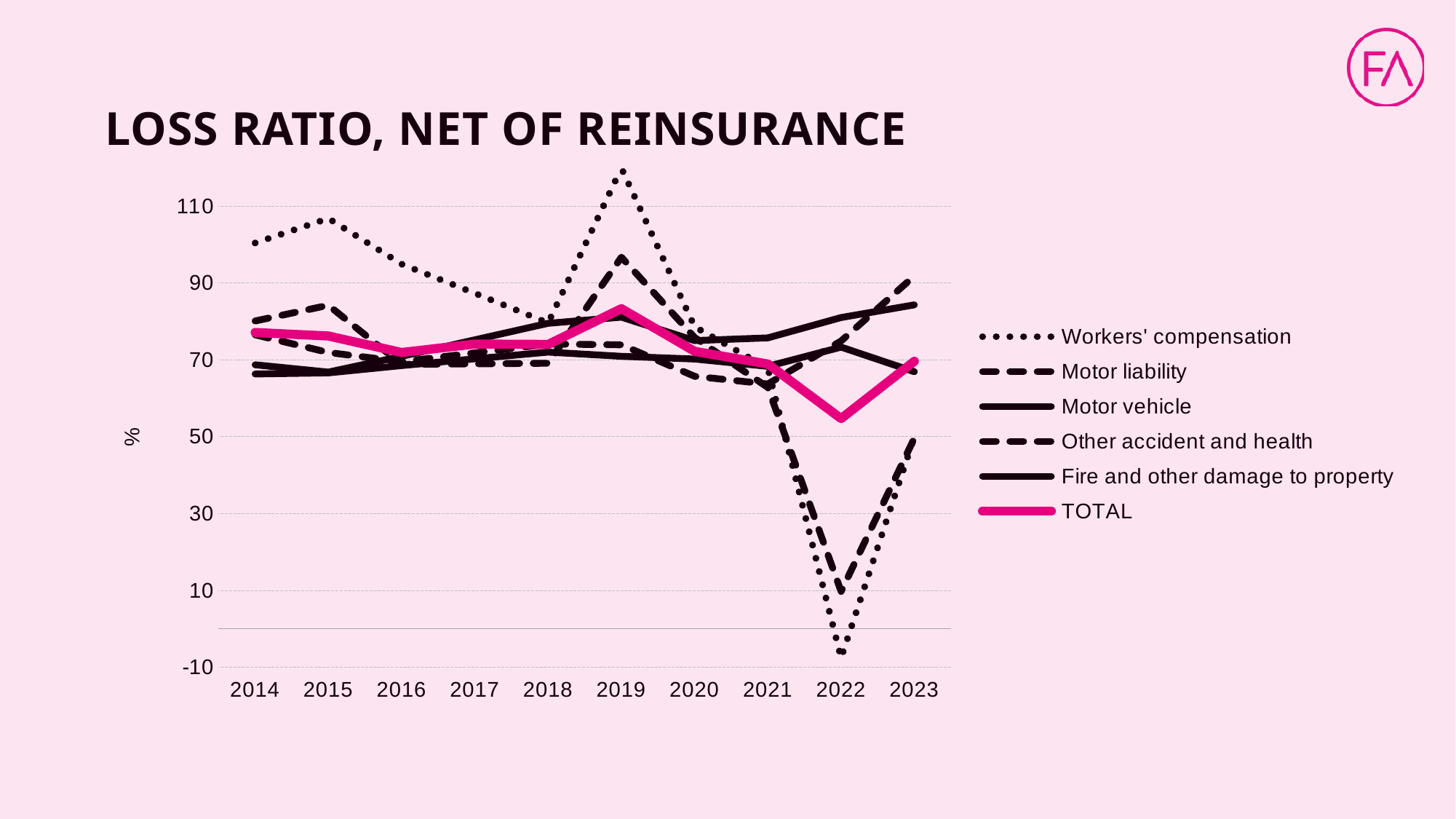
Is the Workers' compensation value for 2022 greater or less than 10? less Which series has the highest value in 2014? Workers' compensation Is the TOTAL value for 2022 greater or less than 70? less What kind of chart is shown on the slide? line chart In which year does the Workers' compensation series reach its lowest value? 2022 In which year does the Workers' compensation series reach its highest value? 2019 Is the Workers' compensation value for 2019 greater or less than 110? greater Does the TOTAL series rise or fall from 2019 to 2022? fall In which year does the TOTAL series reach its lowest value? 2022 How many series does the legend list? 6 What is the title of the chart? LOSS RATIO, NET OF REINSURANCE How many years are shown on the x axis? 10